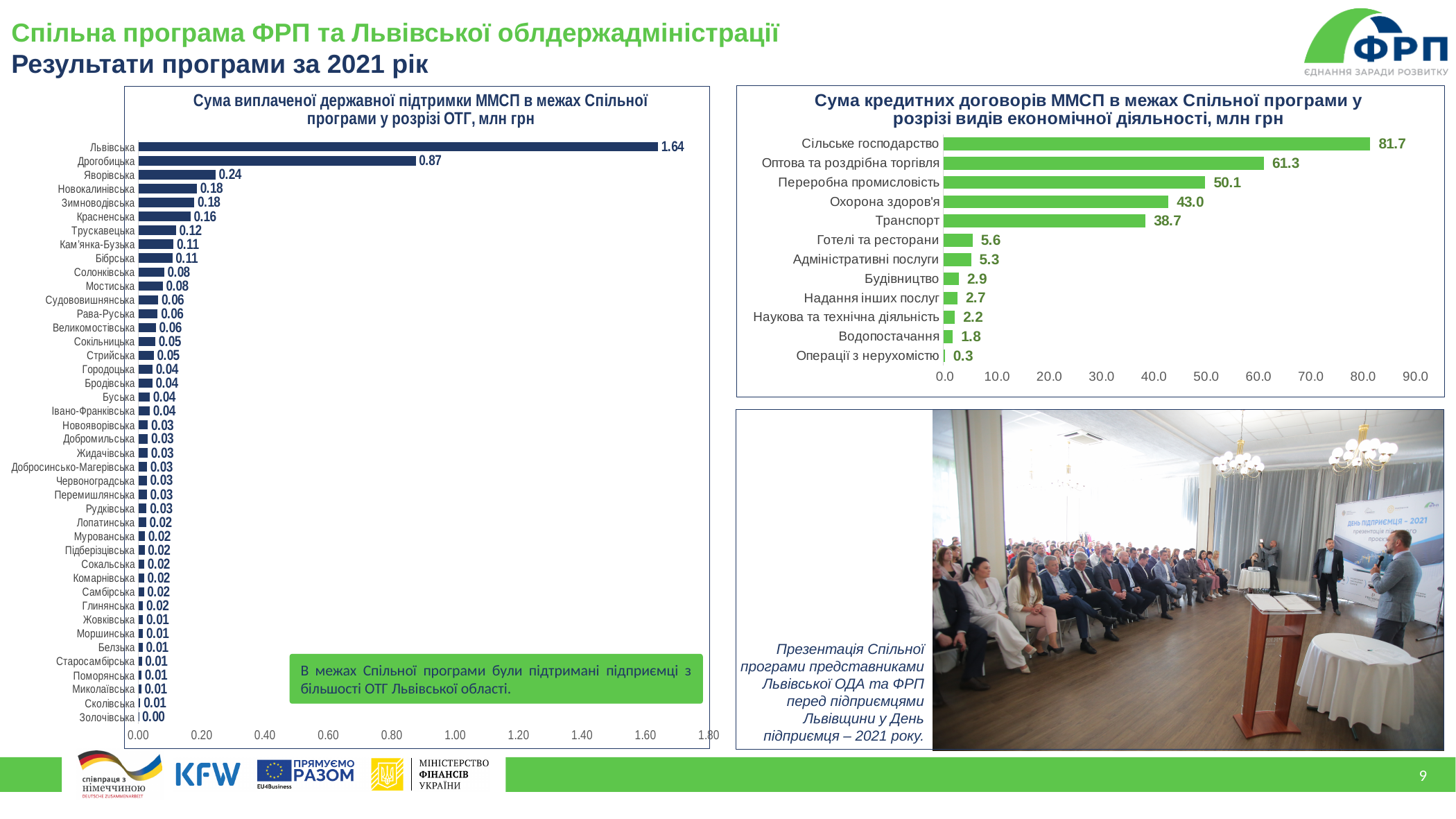
In the chart on the right (Сума кредитних договорів ММСП), what is the value for Транспорт? 38.7 What kind of chart is the chart on the left (Сума виплаченої державної підтримки ММСП)? bar chart In the chart on the right (Сума кредитних договорів ММСП), what is the value for Сільське господарство? 81.7 In the chart on the right (Сума кредитних договорів ММСП), what is the difference between Оптова та роздрібна торгівля and Переробна промисловість? 11.2 In the chart on the right (Сума кредитних договорів ММСП), is the value for Переробна промисловість greater or less than 40.0? greater In the chart on the left (Сума виплаченої державної підтримки ММСП), what is the value for Дрогобицька? 0.87 What colour are the bars in the chart on the right (Сума кредитних договорів ММСП)? green In the chart on the right (Сума кредитних договорів ММСП), which category has the lowest value? Операції з нерухомістю In the chart on the right (Сума кредитних договорів ММСП), which is larger: Охорона здоров'я or Транспорт? Охорона здоров'я In the chart on the left (Сума виплаченої державної підтримки ММСП), which category has the highest value? Львівська In the chart on the left (Сума виплаченої державної підтримки ММСП), what is the difference between Львівська and Дрогобицька? 0.77 How many categories are shown in the chart on the right (Сума кредитних договорів ММСП)? 12